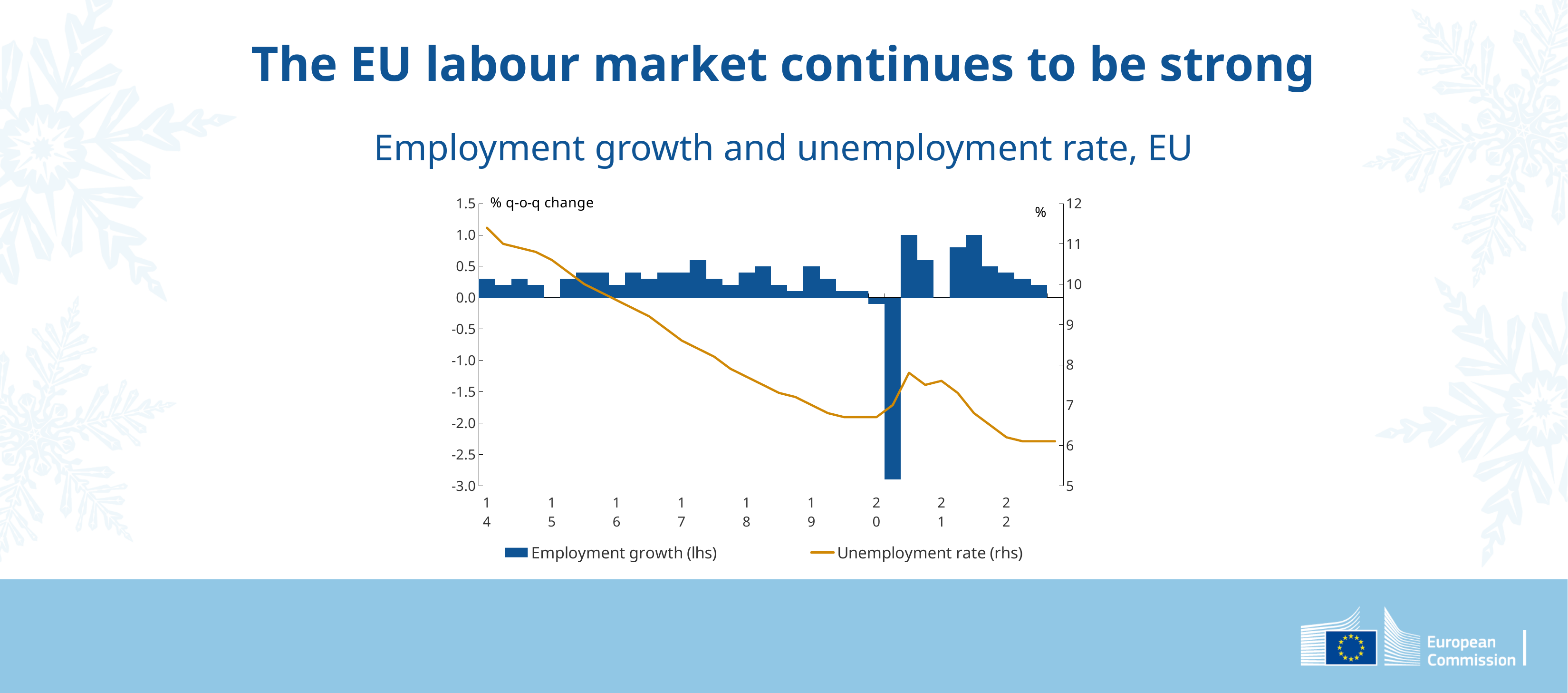
Is the unemployment rate at the start of 2014 greater or less than 11? greater What are the two entries in the chart legend? Employment growth (lhs) and Unemployment rate (rhs) How many year labels are shown on the x axis? 9 What kind of chart is shown on the slide? A combined bar and line chart Which is higher: the unemployment rate at the start of 2014 or at the end of 2022? Start of 2014 Does the unemployment rate line rise or fall between 2014 and 2019? Fall How many series does the chart legend list? 2 Is the unemployment rate at the start of 2018 greater or less than 7? greater What is the title of the chart? Employment growth and unemployment rate, EU Is the unemployment rate at the end of 2022 greater or less than 7? less In which year does the lowest employment growth bar occur? 2020